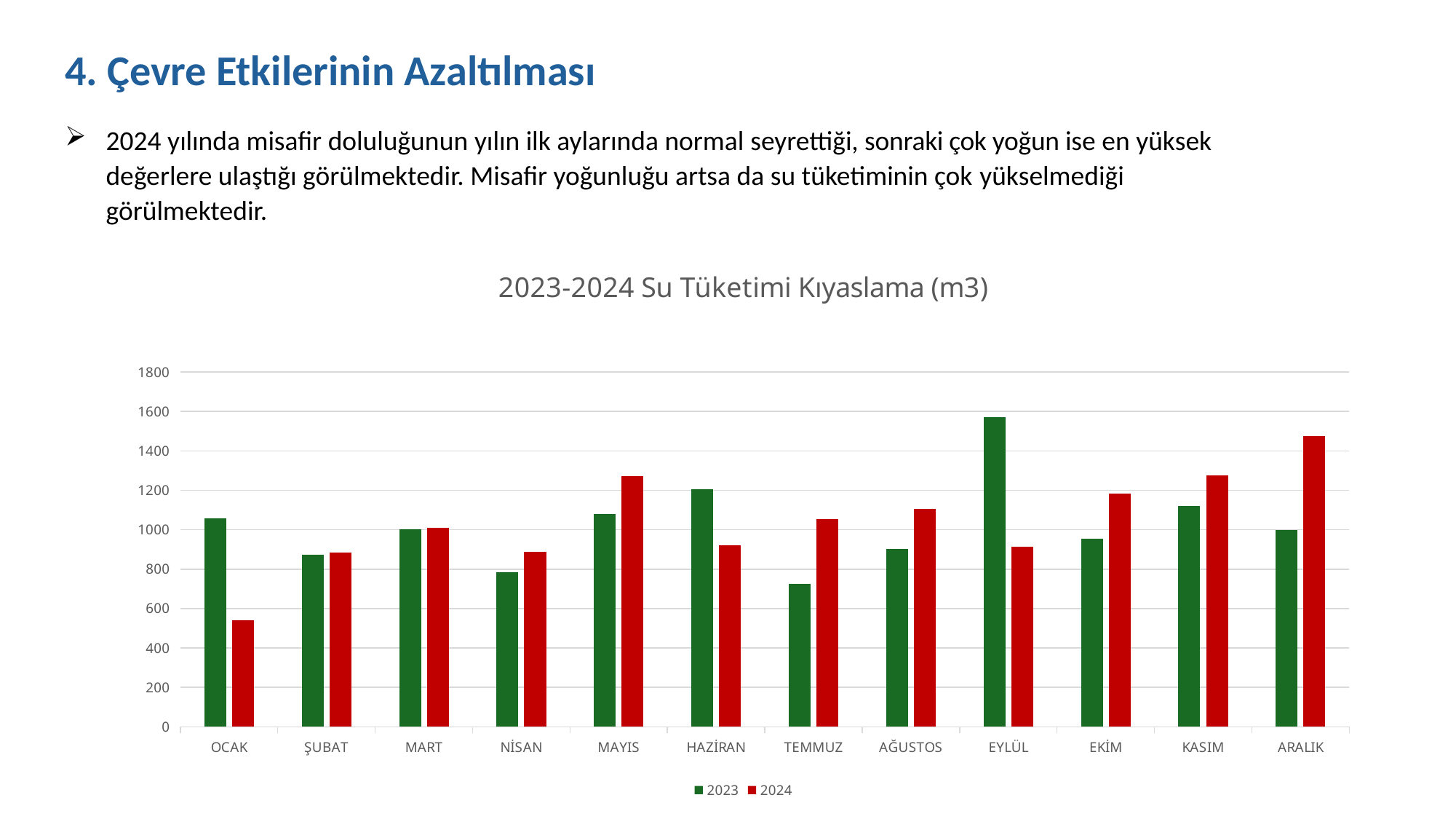
Which month has the lowest 2023 value? TEMMUZ Is the 2024 value for OCAK greater or less than 600? less How many series does the legend list? 2 How many months are shown on the x axis? 12 For HAZİRAN, which series has the larger value, 2023 or 2024? 2023 Is the 2023 value for EYLÜL greater or less than 1400? greater What kind of chart is shown on the slide? bar chart For ARALIK, which series has the larger value, 2023 or 2024? 2024 What is the title of the chart? 2023-2024 Su Tüketimi Kıyaslama (m3) Which month has the highest 2024 value? ARALIK Which month has the lowest 2024 value? OCAK Which month has the highest 2023 value? EYLÜL